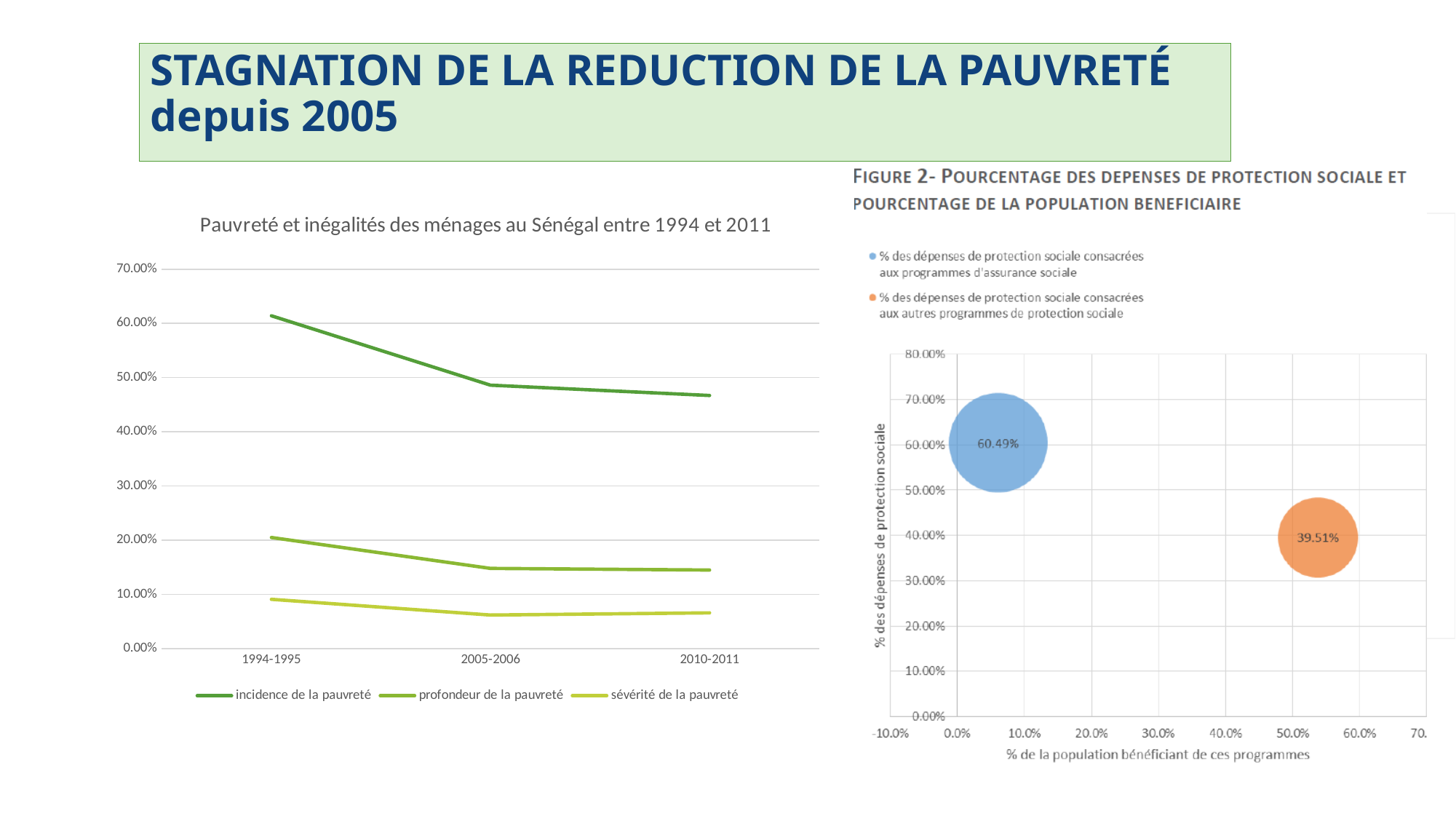
In the left chart 'Pauvreté et inégalités des ménages au Sénégal entre 1994 et 2011', does the 'incidence de la pauvreté' series rise or fall from 1994-1995 to 2010-2011? fall In the right chart 'Figure 2', what is the label of the x axis? % de la population bénéficiant de ces programmes How many periods are shown on the x axis of the left chart 'Pauvreté et inégalités des ménages au Sénégal entre 1994 et 2011'? 3 In the right chart 'Figure 2', what value is labelled on the blue bubble for '% des dépenses de protection sociale consacrées aux programmes d'assurance sociale'? 60.49% What type of chart is the left chart titled 'Pauvreté et inégalités des ménages au Sénégal entre 1994 et 2011'? line chart In the left chart 'Pauvreté et inégalités des ménages au Sénégal entre 1994 et 2011', which series has the highest values across all periods? incidence de la pauvreté In the right chart 'Figure 2', what value is labelled on the orange bubble for '% des dépenses de protection sociale consacrées aux autres programmes de protection sociale'? 39.51% In the right chart 'Figure 2', what is the difference between the blue bubble value (60.49%) and the orange bubble value (39.51%)? 20.98% In the left chart 'Pauvreté et inégalités des ménages au Sénégal entre 1994 et 2011', is the value of 'sévérité de la pauvreté' for 1994-1995 greater or less than 10.00%? less How many series does the legend of the left chart 'Pauvreté et inégalités des ménages au Sénégal entre 1994 et 2011' list? 3 In the left chart 'Pauvreté et inégalités des ménages au Sénégal entre 1994 et 2011', is the value of 'incidence de la pauvreté' for 2005-2006 greater or less than 50.00%? less In the left chart 'Pauvreté et inégalités des ménages au Sénégal entre 1994 et 2011', which series has the lowest values across all periods? sévérité de la pauvreté